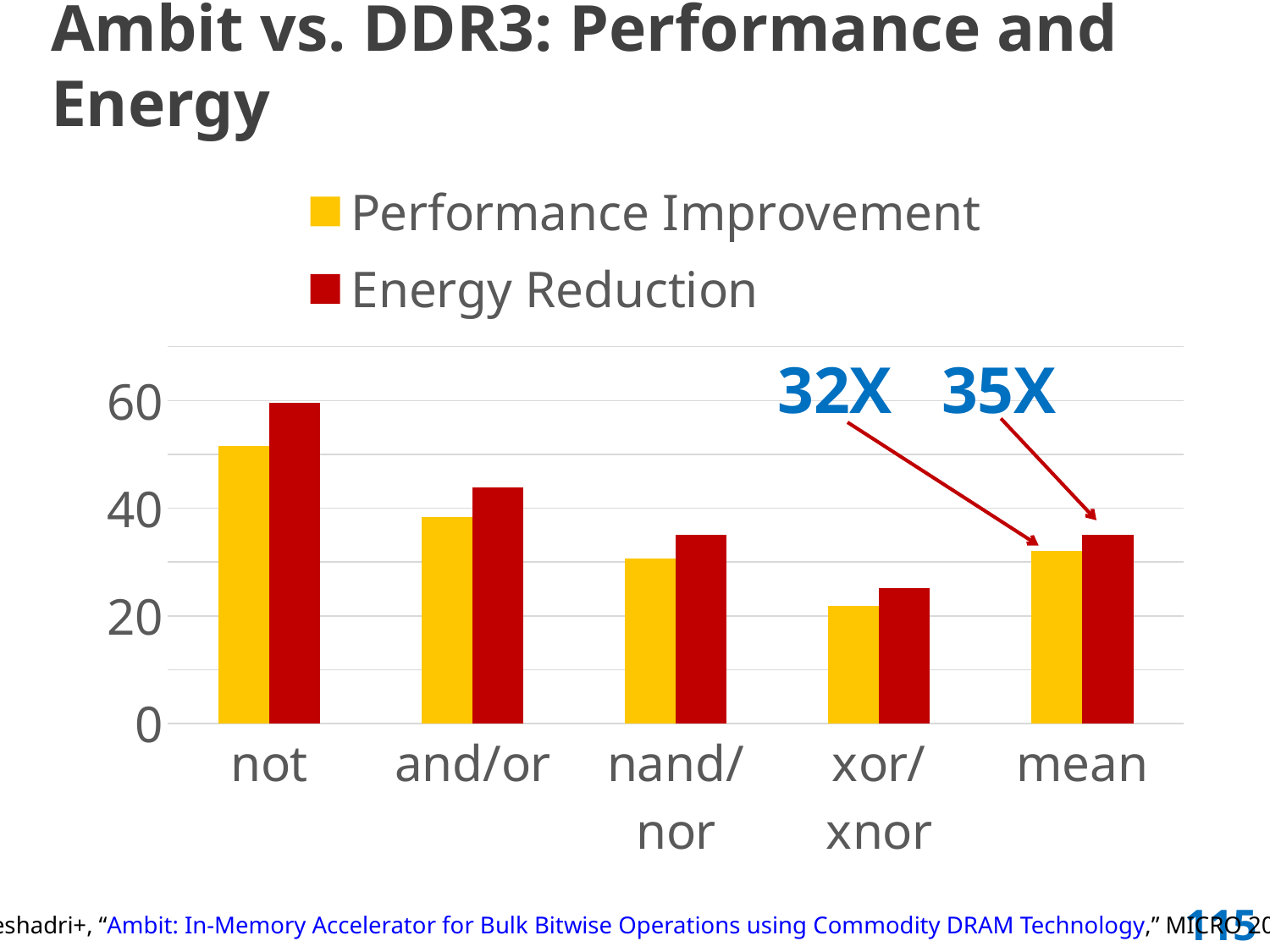
Which colour represents Energy Reduction in the legend? red Is the Performance Improvement value for xor/xnor greater or less than 40? less How many categories are shown on the x axis? 5 For the not category, which is larger: Performance Improvement or Energy Reduction? Energy Reduction What kind of chart is shown on the slide? bar chart Which category has the lowest Performance Improvement bar? xor/xnor What is the Performance Improvement value for the mean category? 32X What is the Energy Reduction value for the mean category? 35X For the mean category, what is the difference between the Energy Reduction and the Performance Improvement values? 3X Which category has the highest Energy Reduction bar? not How many series does the legend list? 2 Is the Energy Reduction value for not greater or less than 40? greater